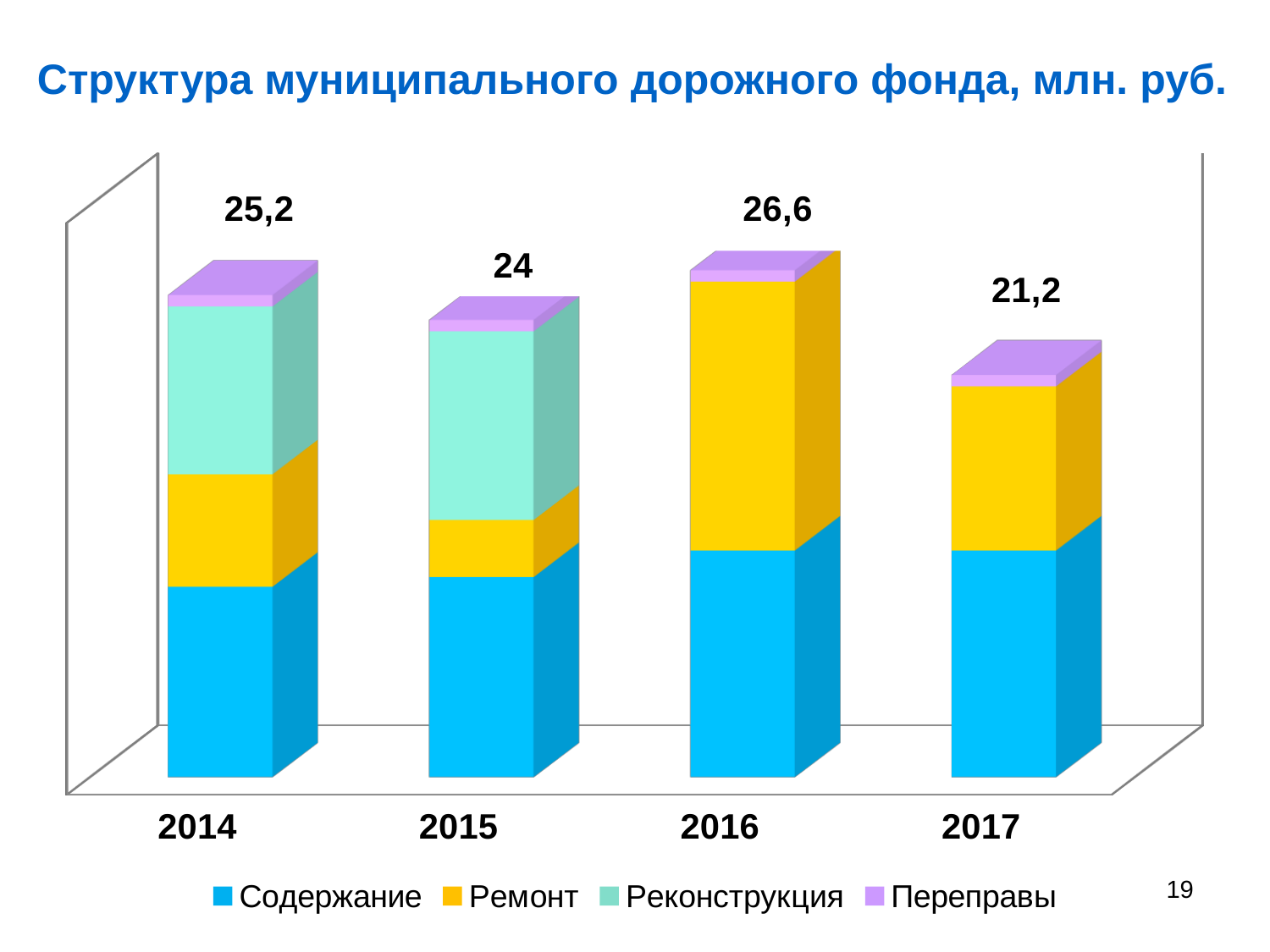
What is the total value shown for 2014? 25,2 How many series does the legend list? 4 What is the total value shown for 2017? 21,2 What kind of chart is shown on the slide? Stacked bar chart What is the difference between the total for 2014 and the total for 2015? 1,2 Which is larger, the total for 2015 or the total for 2017? 2015 What is the total value shown for 2016? 26,6 Which legend entry is shown in yellow? Ремонт What is the difference between the total for 2016 and the total for 2017? 5,4 How many years are shown on the x axis? 4 Which year has the lowest total value? 2017 Which year has the highest total value? 2016